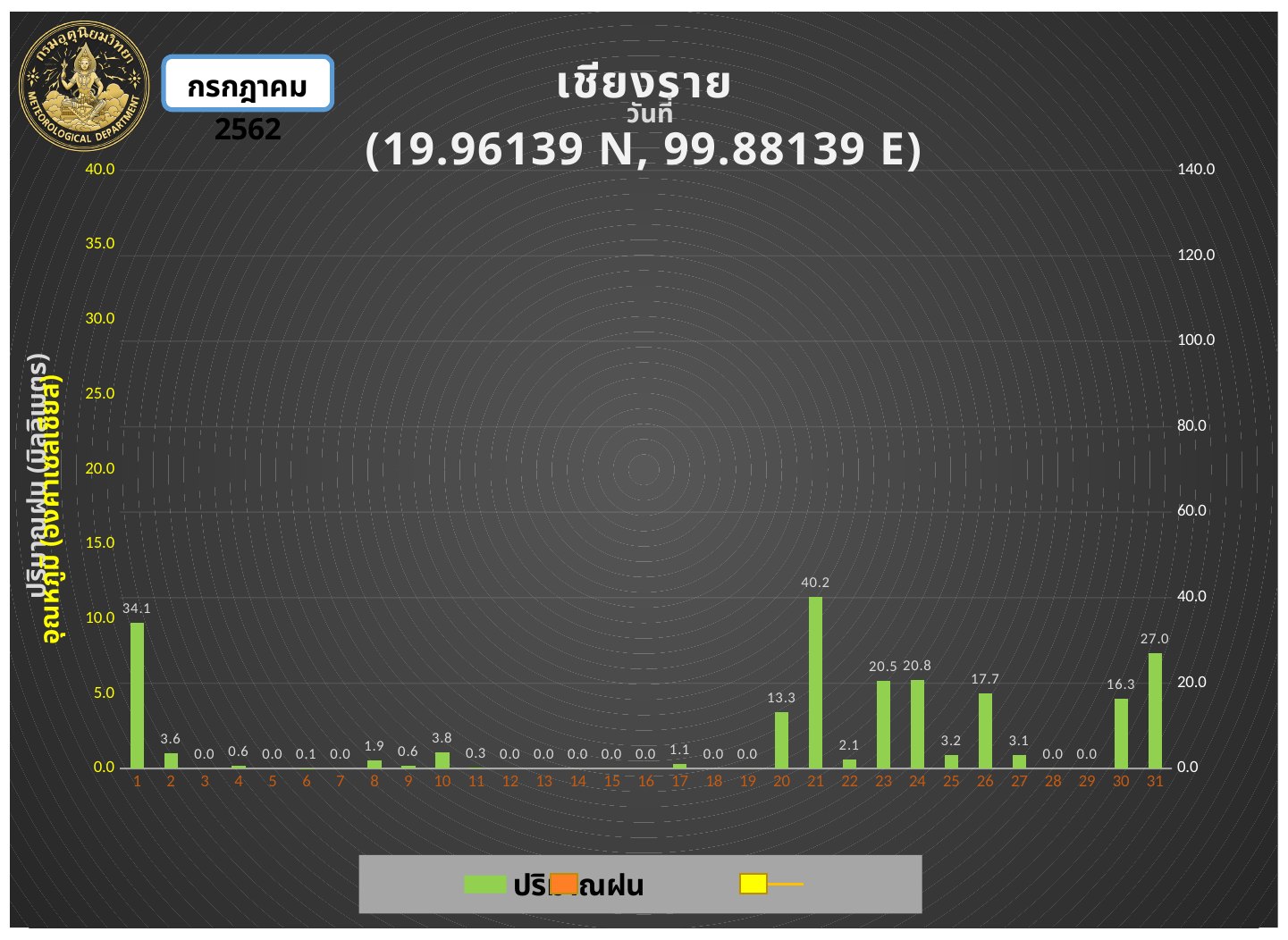
What is the difference between the rainfall values for day 21 and day 31? 13.2 What kind of chart is shown on the slide? bar chart What is the difference between the rainfall values for day 24 and day 23? 0.3 How many entries does the legend list? 3 Which day has the highest rainfall value? 21 Which is larger, the rainfall value for day 26 or for day 20? day 26 What is the rainfall value for day 30? 16.3 Is the rainfall value for day 31 greater or less than 20.0 on the right axis? greater What is the rainfall value for day 1? 34.1 How many days are shown on the x axis? 31 What is the rainfall value for day 21? 40.2 What colour are the rainfall (ปริมาณฝน) bars? green